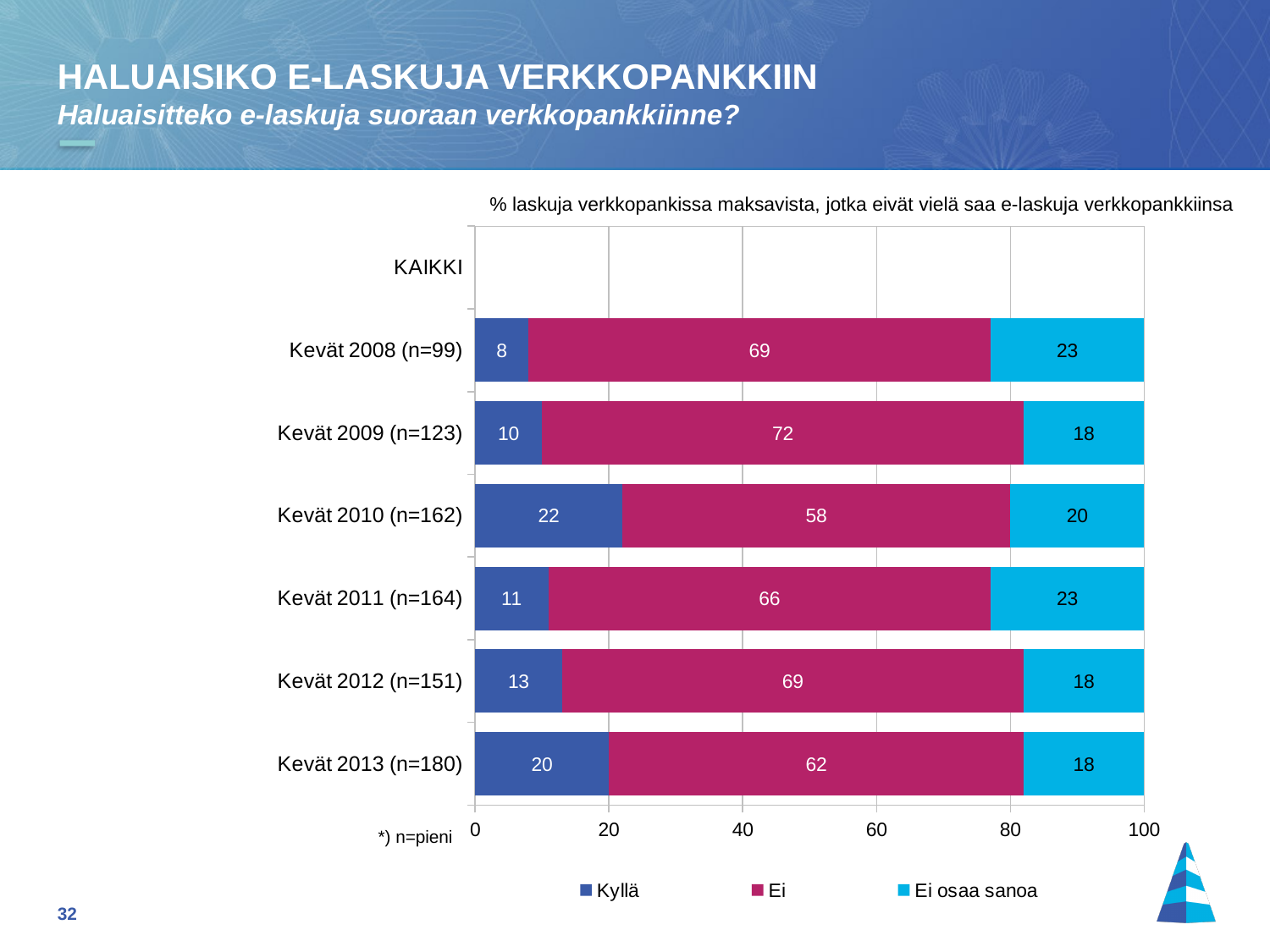
How many series does the legend list? 3 Which series is shown in the pink/magenta colour? Ei What is the Kyllä value for Kevät 2013 (n=180)? 20 What is the total of the stacked bar for Kevät 2010 (n=162)? 100 What kind of chart is shown on the slide? Stacked bar chart Which category has the lowest Ei value? Kevät 2010 (n=162) Which category has the lowest Kyllä value? Kevät 2008 (n=99) What is the Ei value for Kevät 2009 (n=123)? 72 Which is larger: the Kyllä value for Kevät 2012 (n=151) or the Kyllä value for Kevät 2013 (n=180)? Kevät 2013 (n=180) What is the Ei osaa sanoa value for Kevät 2011 (n=164)? 23 What is the difference between the Ei value for Kevät 2009 (n=123) and the Ei value for Kevät 2013 (n=180)? 10 Which category has the highest Kyllä value? Kevät 2010 (n=162)